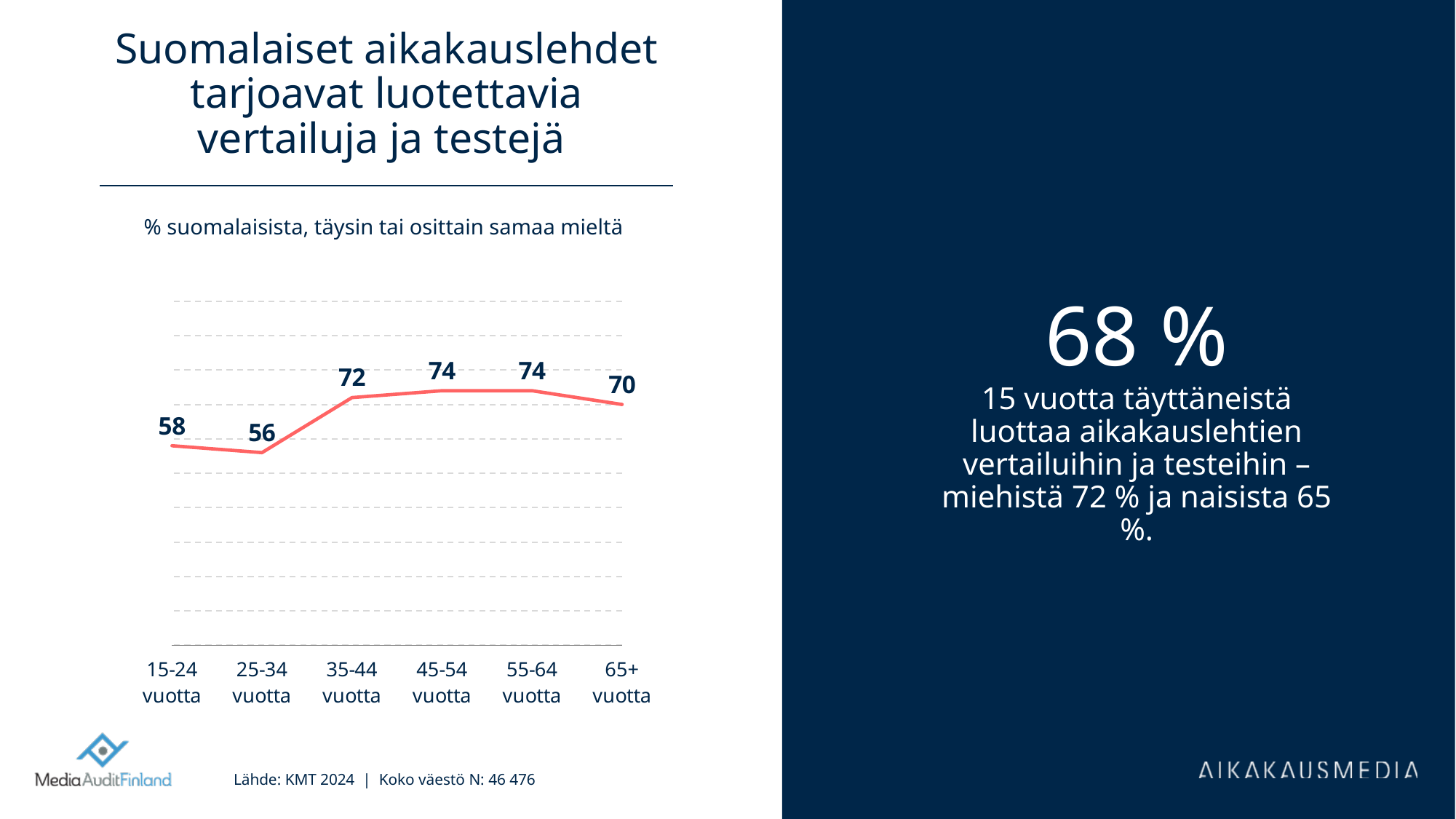
What kind of chart is shown on the slide? Line chart Which is larger, the value for 15-24 vuotta or the value for 25-34 vuotta? 15-24 vuotta What is the value for the 35-44 vuotta age group? 72 What is the subtitle shown above the chart? % suomalaisista, täysin tai osittain samaa mieltä What is the value for the 65+ vuotta age group? 70 What is the difference between the values for 65+ vuotta and 15-24 vuotta? 12 How many age groups are plotted on the chart? 6 What is the value for the 15-24 vuotta age group? 58 Which age group has the lowest value? 25-34 vuotta What is the highest value shown on the chart? 74 Does the value rise or fall from 55-64 vuotta to 65+ vuotta? Fall What is the difference between the values for 35-44 vuotta and 25-34 vuotta? 16